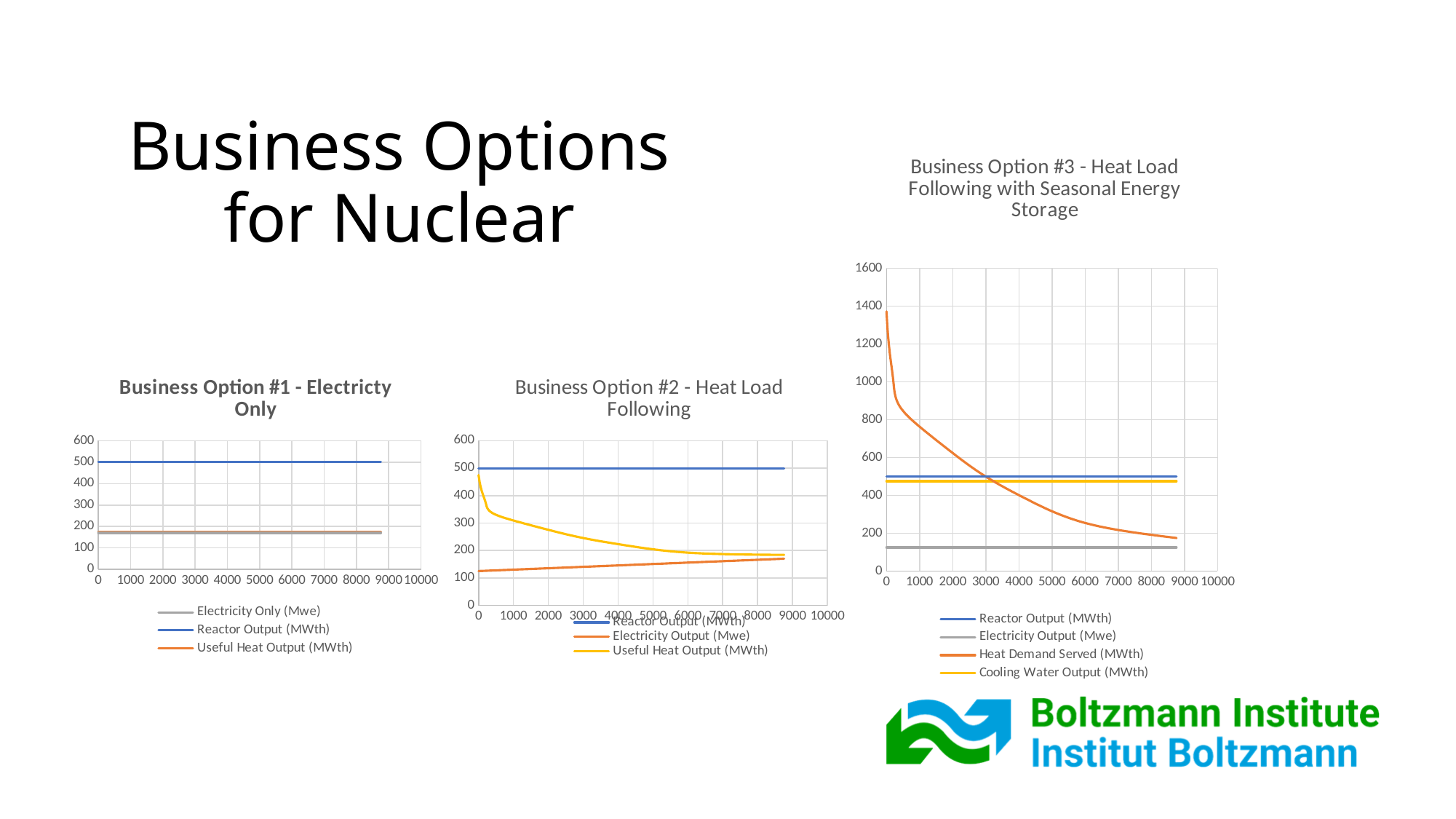
In "Business Option #2 - Heat Load Following", at x = 1000, which is larger: Useful Heat Output (MWth) or Electricity Output (Mwe)? Useful Heat Output (MWth) In "Business Option #2 - Heat Load Following", does Useful Heat Output (MWth) rise or fall along the x axis? fall In "Business Option #3 - Heat Load Following with Seasonal Energy Storage", at x = 8000, which is larger: Cooling Water Output (MWth) or Heat Demand Served (MWth)? Cooling Water Output (MWth) What colour is the Useful Heat Output (MWth) line in "Business Option #2 - Heat Load Following"? yellow In "Business Option #1 - Electricty Only", is the value for Electricity Only (Mwe) greater or less than 200? less In "Business Option #3 - Heat Load Following with Seasonal Energy Storage", does Heat Demand Served (MWth) rise or fall along the x axis? fall How many series does the legend of "Business Option #2 - Heat Load Following" list? 3 What kind of chart is "Business Option #1 - Electricty Only"? line chart In "Business Option #3 - Heat Load Following with Seasonal Energy Storage", is the starting value of Heat Demand Served (MWth) at x = 0 greater or less than 1200? greater How many series does the legend of "Business Option #3 - Heat Load Following with Seasonal Energy Storage" list? 4 In "Business Option #2 - Heat Load Following", does Electricity Output (Mwe) rise or fall along the x axis? rise In "Business Option #1 - Electricty Only", is the value for Reactor Output (MWth) greater or less than 400? greater